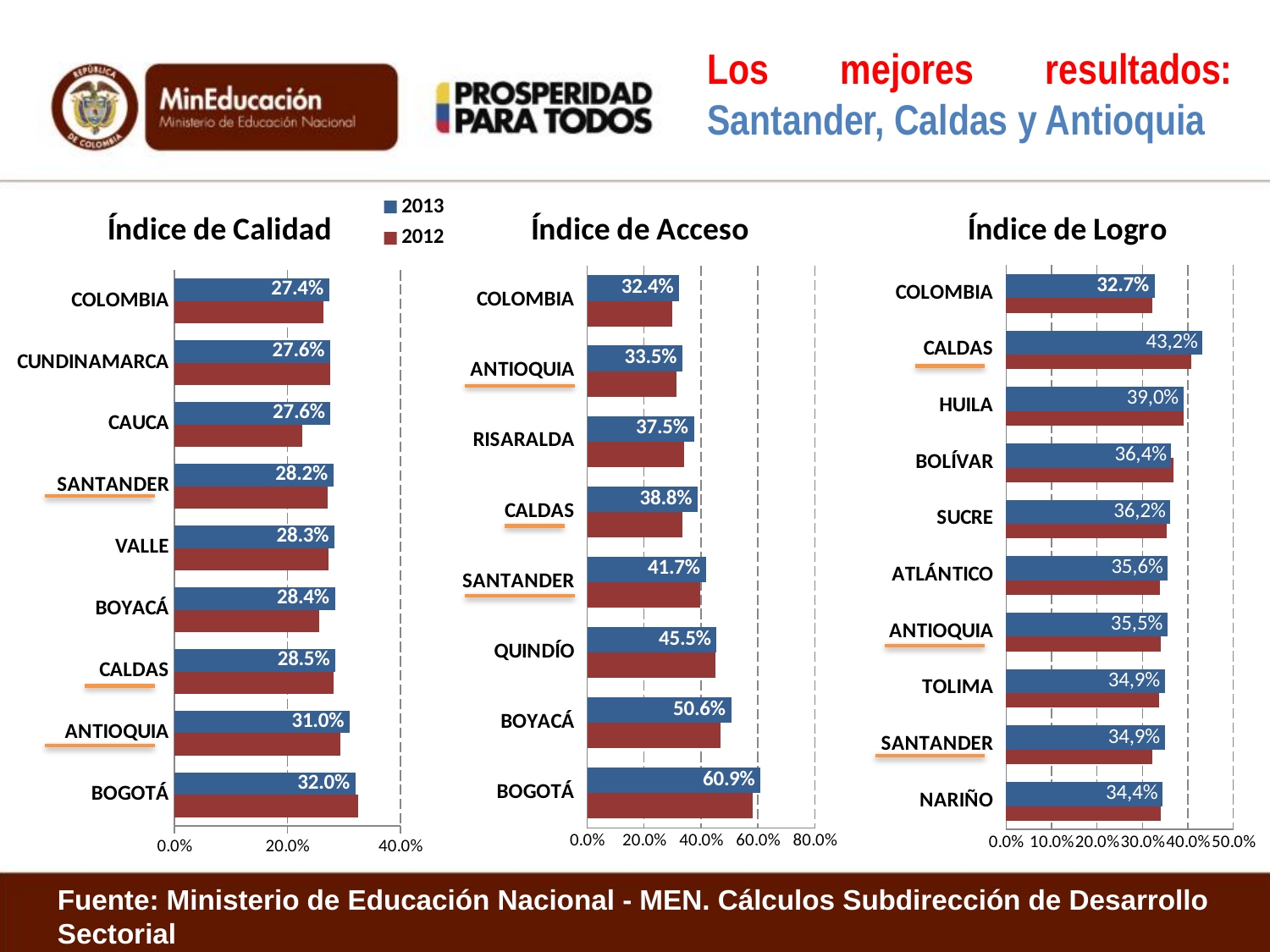
In the Índice de Calidad chart, which category has the lowest 2013 value? COLOMBIA In the Índice de Acceso chart, which category has the highest 2013 value? BOGOTÁ In the Índice de Acceso chart, how many categories are shown? 8 In the Índice de Acceso chart, what is the 2013 value for QUINDÍO? 45.5% In the Índice de Calidad chart, what is the difference between the 2013 values for ANTIOQUIA and SANTANDER? 2.8% What kind of chart is the Índice de Calidad chart? bar chart How many series does the legend list? 2 In the Índice de Logro chart, which category has the lowest 2013 value? COLOMBIA In the Índice de Logro chart, what is the 2013 value for CALDAS? 43,2% In the Índice de Calidad chart, what is the 2013 value for BOGOTÁ? 32.0% In the Índice de Acceso chart, is the 2013 value for BOYACÁ greater or less than the 2013 value for CALDAS? greater